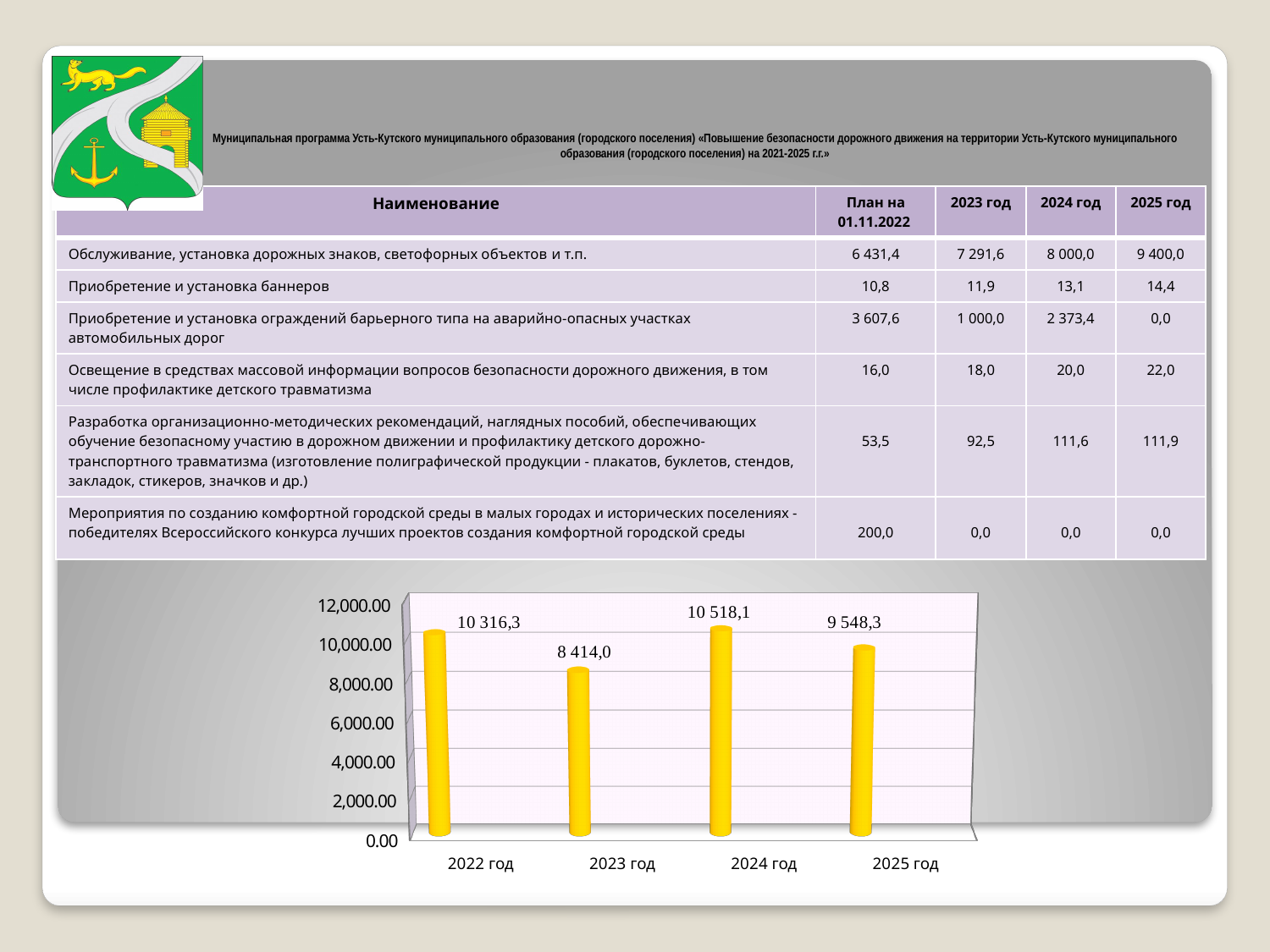
What colour are the bars in the chart? yellow How many years (categories) are plotted in the chart? 4 What is the value shown for 2025 год in the chart? 9 548,3 What is the difference between the values for 2024 год and 2023 год in the chart? 2 104,1 Which year has the lowest value in the chart? 2023 год What is the value shown for 2022 год in the chart? 10 316,3 Is the value for 2023 год in the chart greater or less than 10,000.00? less What kind of chart is shown at the bottom of the slide? bar chart What is the value shown for 2024 год in the chart? 10 518,1 What is the value shown for 2023 год in the chart? 8 414,0 Which is larger in the chart, the value for 2022 год or the value for 2025 год? 2022 год Which year has the highest value in the chart? 2024 год